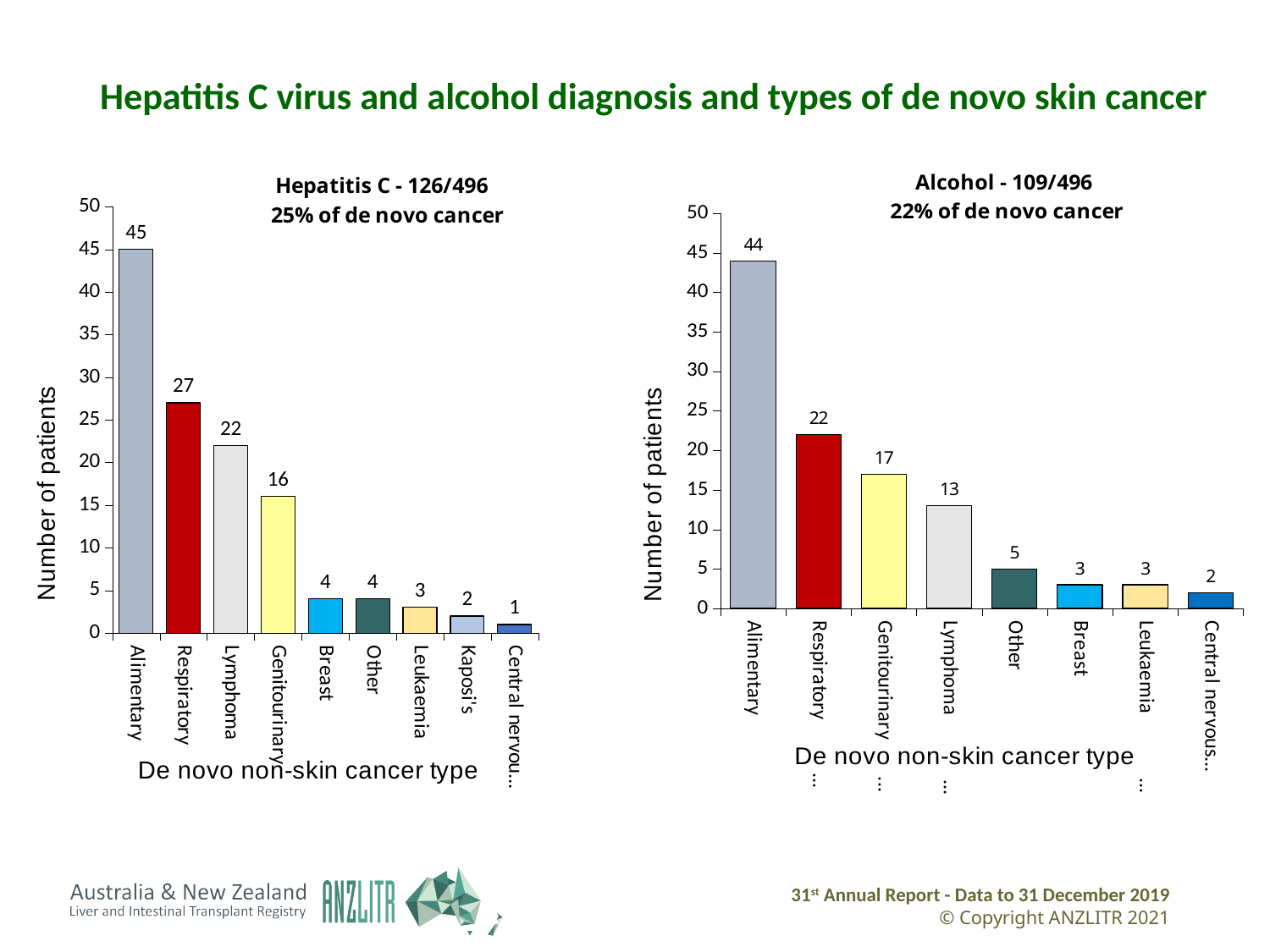
In the Hepatitis C chart, which cancer type has the lowest number of patients? Central nervous In the Alcohol chart, which cancer type has the highest number of patients? Alimentary In the Alcohol chart, what is the difference between the Alimentary and Respiratory values? 22 What percentage of de novo cancer does the Hepatitis C chart title state? 25% In the Alcohol chart, how many patients are in the Genitourinary category? 17 Which is larger: the Lymphoma value in the Hepatitis C chart or the Lymphoma value in the Alcohol chart? Hepatitis C chart What kind of chart is the Alcohol chart? Bar chart How many cancer type categories are shown in the Hepatitis C chart? 9 In the Hepatitis C chart, what is the difference between the Respiratory and Lymphoma values? 5 In the Alcohol chart, is the value for Respiratory greater or less than 20? greater How many cancer type categories are shown in the Alcohol chart? 8 In the Hepatitis C chart, how many patients are in the Alimentary category? 45